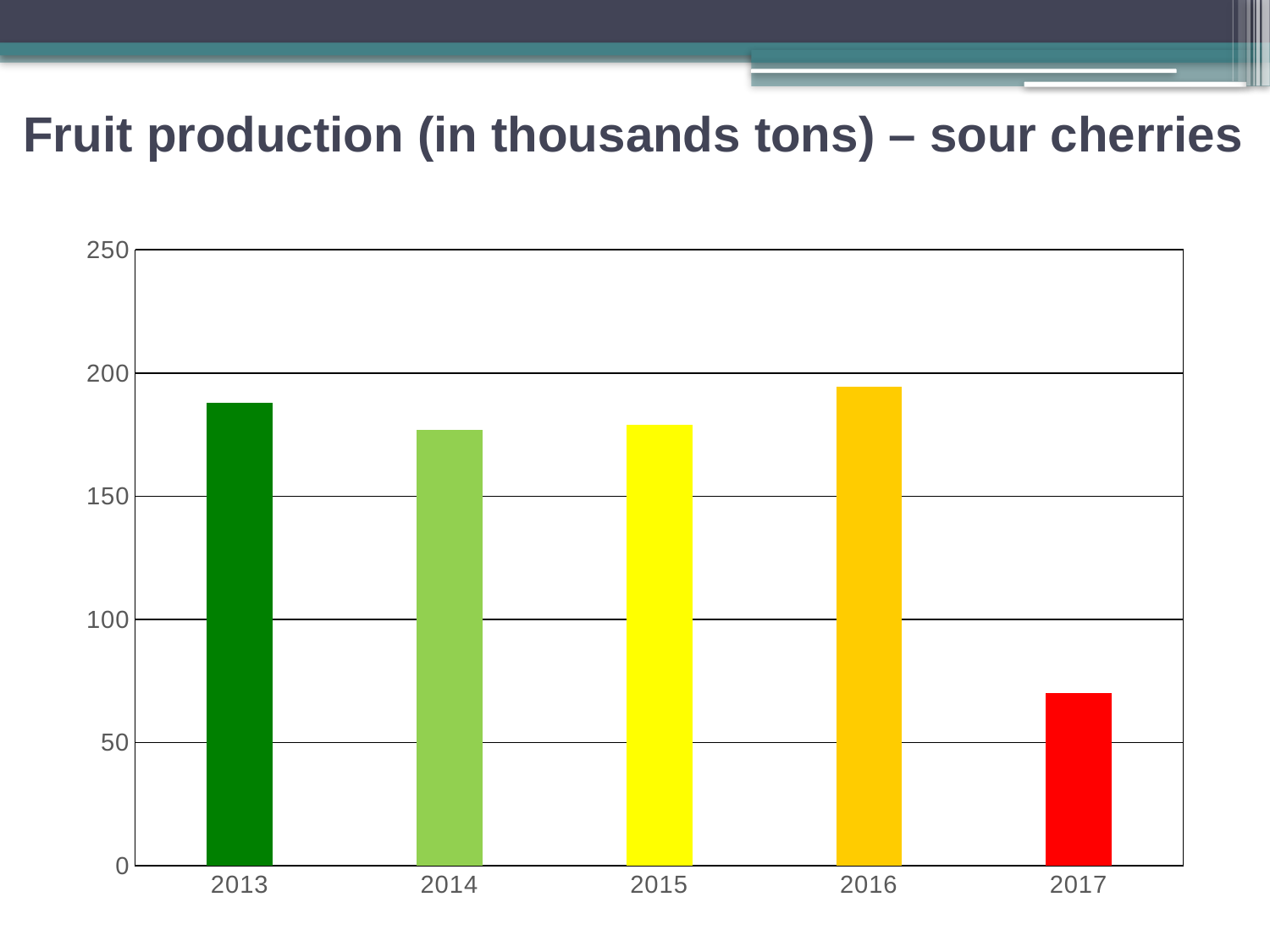
Is the value for 2013 greater or less than 150? greater Which year has the highest sour cherry production in the chart? 2016 Is the value for 2017 greater or less than 100? less Is the value for 2017 greater or less than 50? greater What is the title of the slide containing the chart? Fruit production (in thousands tons) – sour cherries What kind of chart is shown on the slide? bar chart Which year has the larger value, 2013 or 2014? 2013 Does the value rise or fall from 2016 to 2017? fall Which year has the lowest sour cherry production in the chart? 2017 How many years are shown on the x axis of the chart? 5